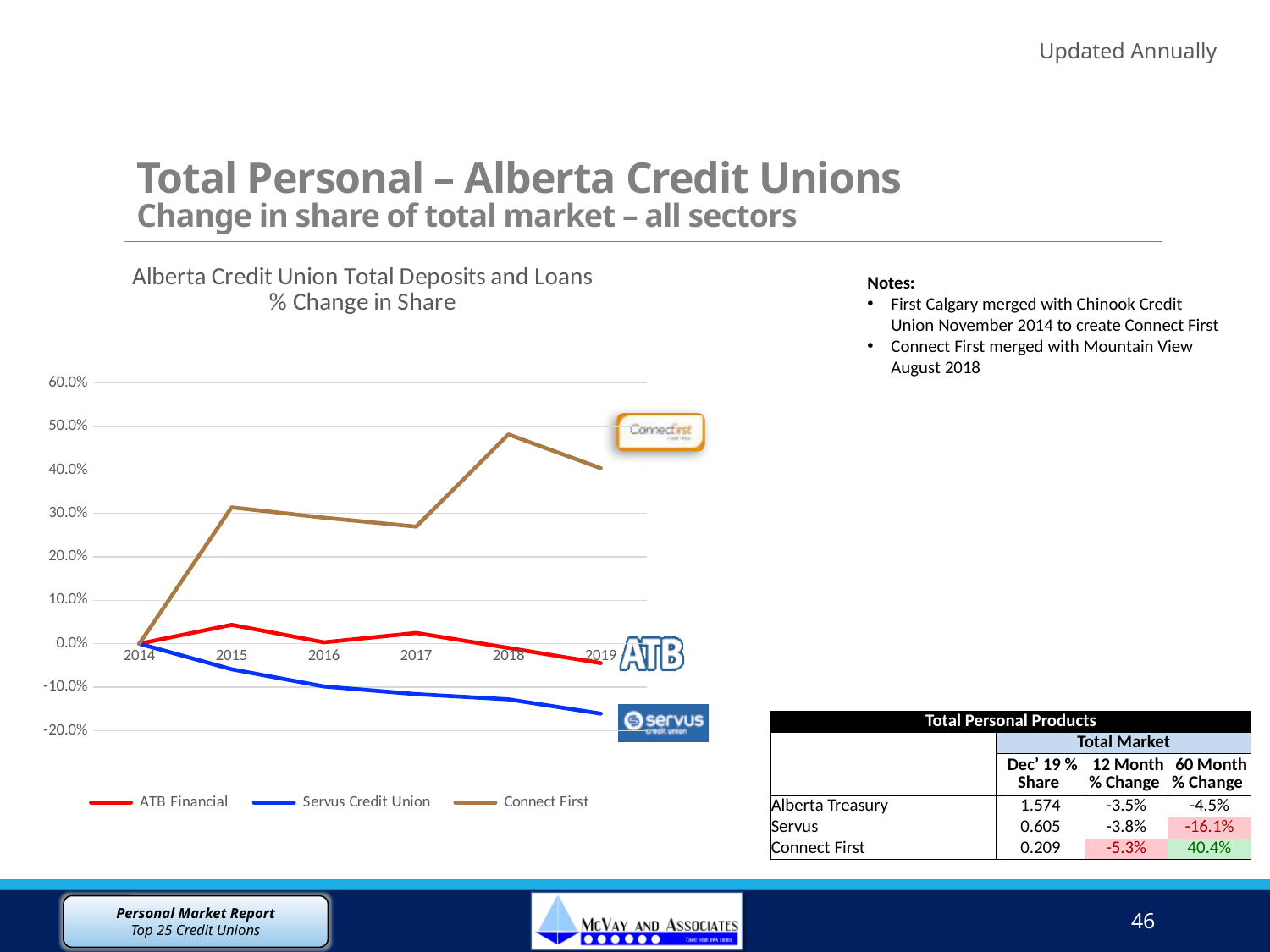
In 2017, which is larger: the value for ATB Financial or the value for Servus Credit Union? ATB Financial Is the value for Connect First in 2015 greater or less than 20.0%? greater Is the value for Servus Credit Union in 2019 greater or less than -10.0%? less Which series has the lowest value in 2019? Servus Credit Union Does the Connect First line rise or fall from 2018 to 2019? Fall Which series has the highest value in 2018? Connect First How many years are plotted along the x axis of the chart? 6 What is the title of the chart? Alberta Credit Union Total Deposits and Loans % Change in Share How many series does the chart legend list? 3 Does the Servus Credit Union line rise or fall from 2014 to 2019? Fall What kind of chart is shown on the slide? Line chart Is the value for Connect First in 2018 greater or less than 40.0%? greater